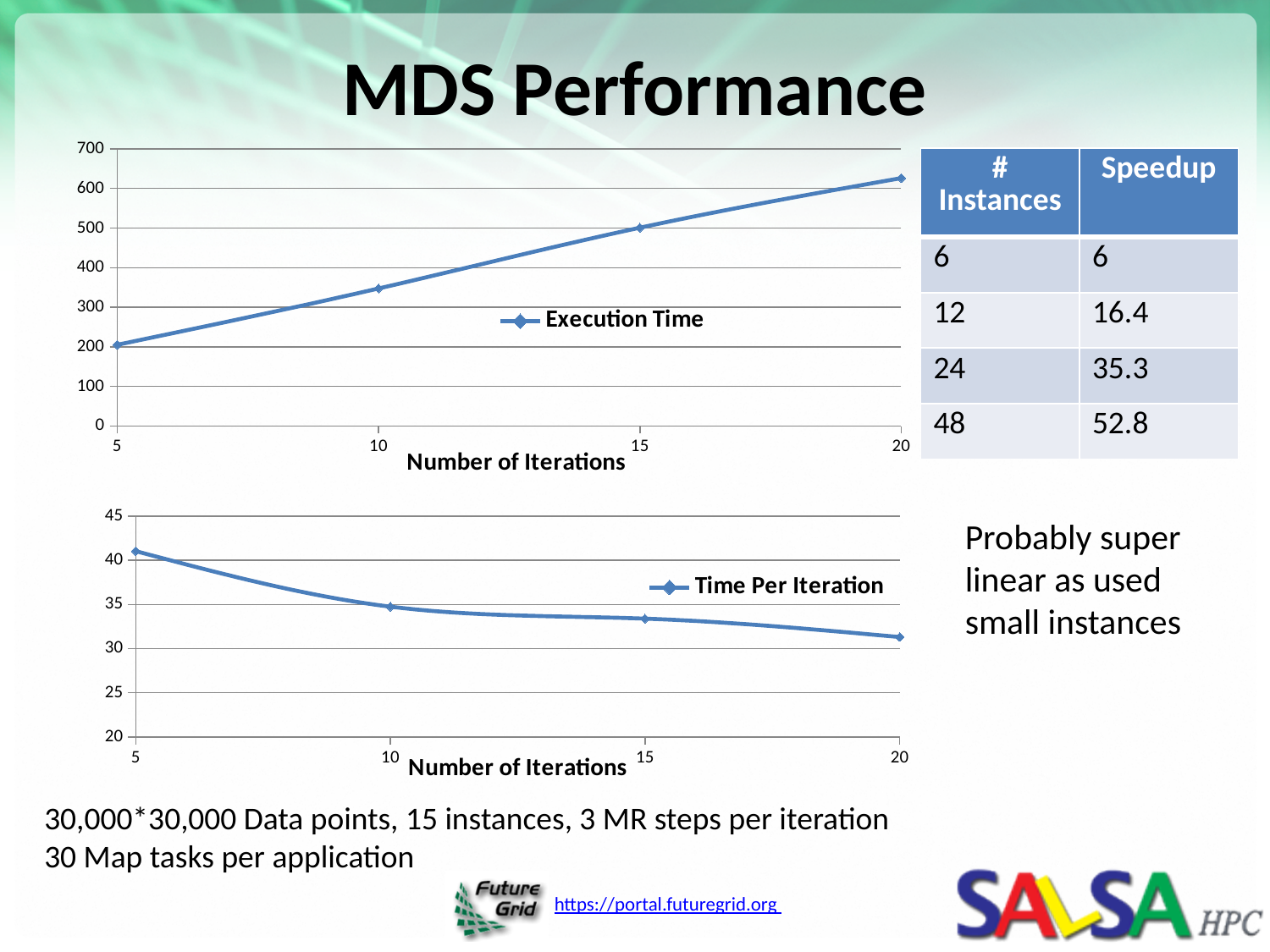
How many data points are plotted in the top chart (Execution Time)? 4 What is the x-axis title of the top chart (Execution Time)? Number of Iterations What kind of chart is the top chart (Execution Time)? line chart In the bottom chart (Time Per Iteration), do the values rise or fall as the number of iterations increases? fall In the top chart (Execution Time), at which number of iterations is the execution time highest? 20 In the top chart (Execution Time), is the value at 20 iterations greater or less than 600? greater In the top chart (Execution Time), is the value at 10 iterations greater or less than 300? greater How many series does the legend of the bottom chart (Time Per Iteration) list? 1 In the bottom chart (Time Per Iteration), is the value at 20 iterations greater or less than 35? less In the bottom chart (Time Per Iteration), at which number of iterations is the time per iteration lowest? 20 In the top chart (Execution Time), do the values rise or fall as the number of iterations increases? rise